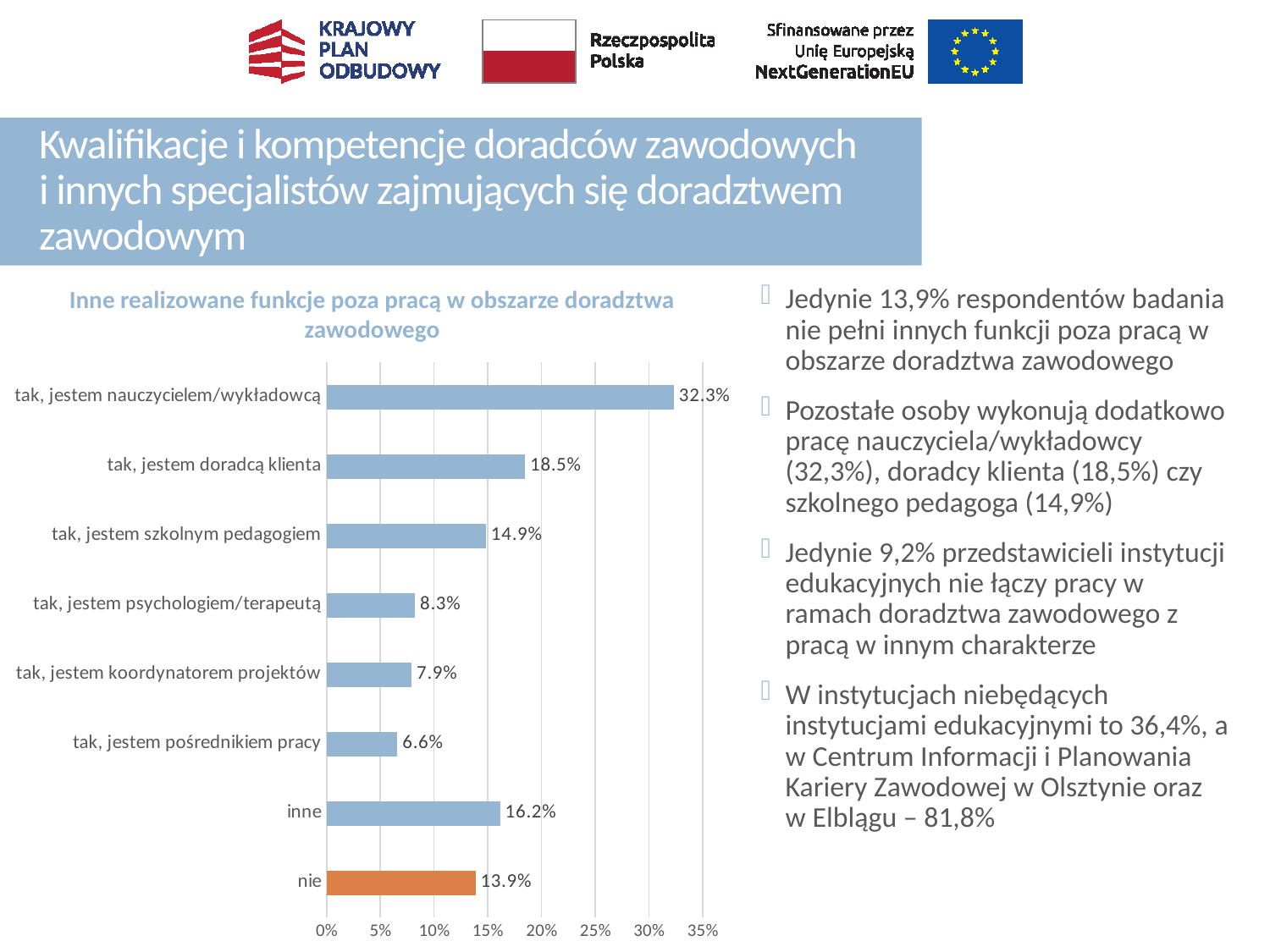
What is the title of the chart? Inne realizowane funkcje poza pracą w obszarze doradztwa zawodowego What is the value for "nie"? 13.9% Which category has the lowest value? tak, jestem pośrednikiem pracy What is the value for "tak, jestem pośrednikiem pracy"? 6.6% Is the value for "tak, jestem psychologiem/terapeutą" greater or less than 10%? less What is the difference between "tak, jestem doradcą klienta" and "tak, jestem szkolnym pedagogiem"? 3.6% What is the value for "tak, jestem nauczycielem/wykładowcą"? 32.3% What kind of chart is this? bar chart Which is larger: "inne" or "nie"? inne Which category has the highest value? tak, jestem nauczycielem/wykładowcą Which bar is coloured differently (orange) from the others? nie How many categories are shown in the chart? 8